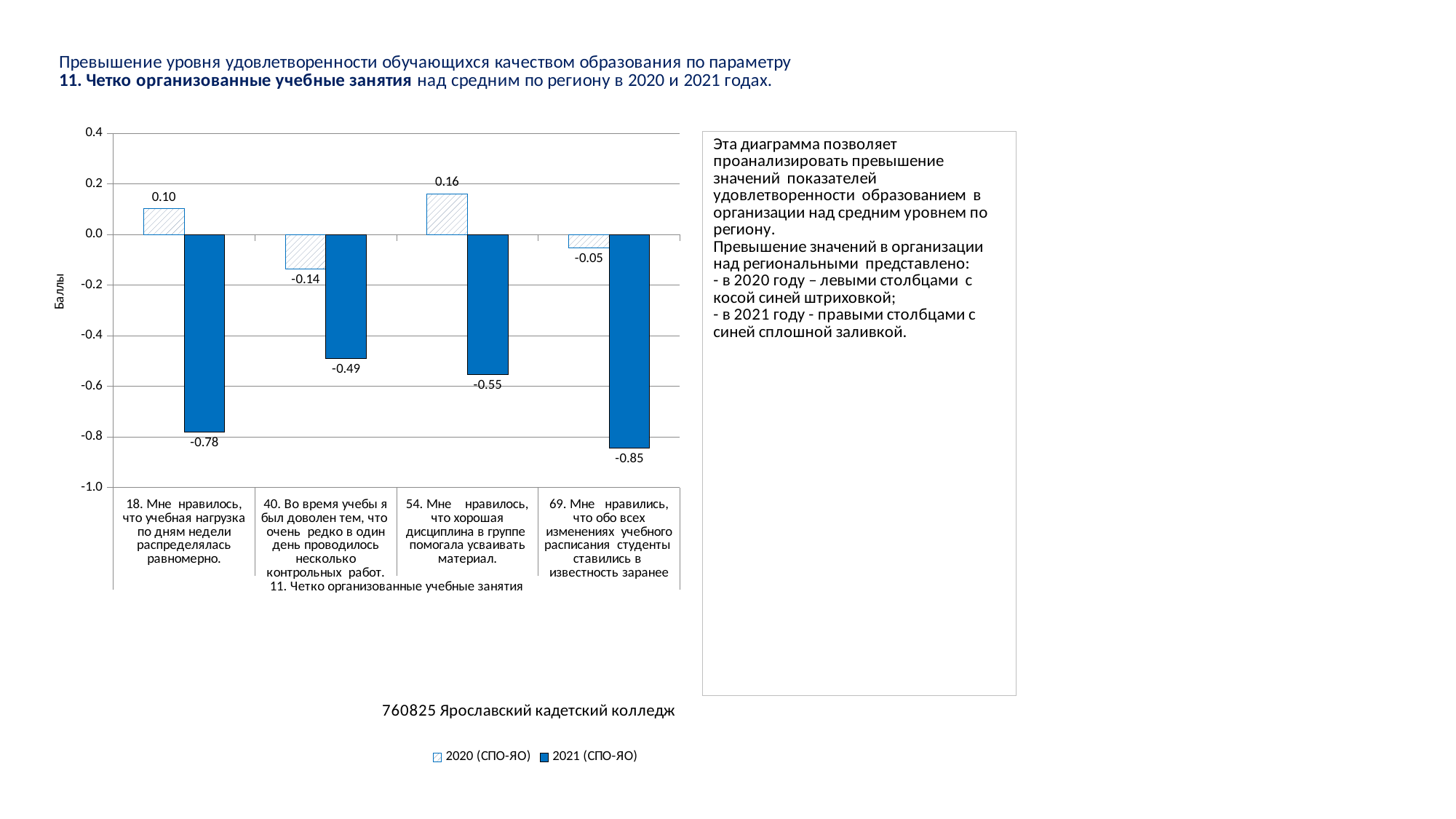
What is the 2021 (СПО-ЯО) value for question 40 ("Во время учебы я был доволен тем, что очень редко в один день проводилось несколько контрольных работ")? -0.49 Which category has the lowest 2021 (СПО-ЯО) value? 69. Мне нравились, что обо всех изменениях учебного расписания студенты ставились в известность заранее What type of chart is shown on the slide? bar chart Which category has the highest 2020 (СПО-ЯО) value? 54. Мне нравилось, что хорошая дисциплина в группе помогала усваивать материал. What is the difference between the 2020 and 2021 values for question 18? 0.88 What is the 2021 (СПО-ЯО) value for question 69 ("Мне нравились, что обо всех изменениях учебного расписания студенты ставились в известность заранее")? -0.85 How many categories (questions) are shown on the x axis of the chart? 4 What is the 2020 (СПО-ЯО) value for question 18 ("Мне нравилось, что учебная нагрузка по дням недели распределялась равномерно")? 0.10 What is the label of the vertical axis of the chart? Баллы For question 54, which series has the larger value, 2020 (СПО-ЯО) or 2021 (СПО-ЯО)? 2020 (СПО-ЯО) How many series does the chart legend list? 2 Is the 2021 (СПО-ЯО) value for question 54 greater or less than -0.4? less